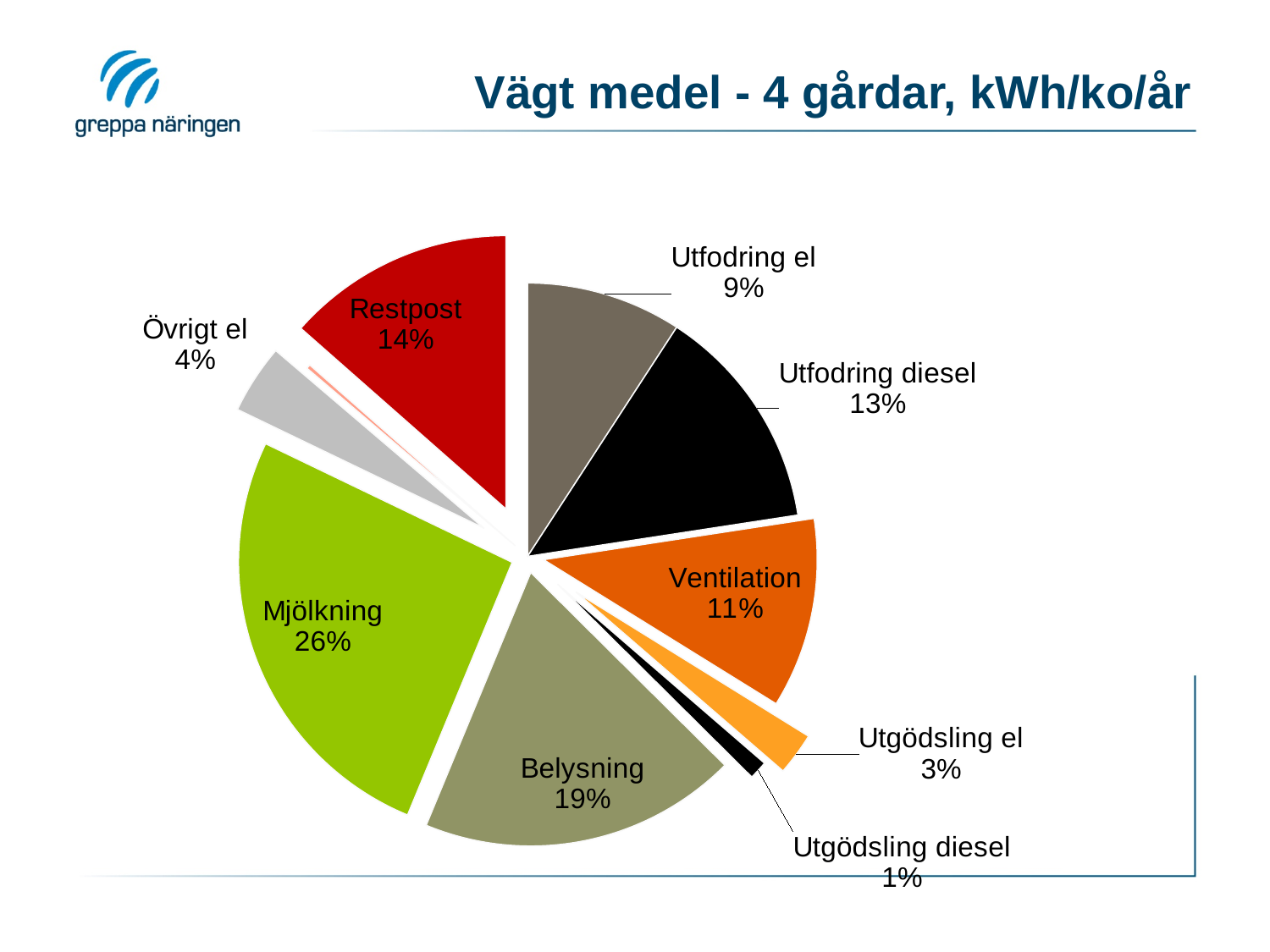
What type of chart is shown on the slide? pie chart What percentage is shown for Restpost? 14% What percentage is shown for Ventilation? 11% What percentage is shown for Utfodring diesel? 13% What is the title of the chart? Vägt medel - 4 gårdar, kWh/ko/år What is the combined share of Utgödsling el and Utgödsling diesel? 4% Which labeled category has the smallest share of the pie? Utgödsling diesel What percentage is shown for Belysning? 19% What share of the pie does Mjölkning account for? 26% Which labeled category has the largest share of the pie? Mjölkning What is the difference in percentage points between Mjölkning and Belysning? 7 Which is larger, Utfodring el or Utfodring diesel? Utfodring diesel